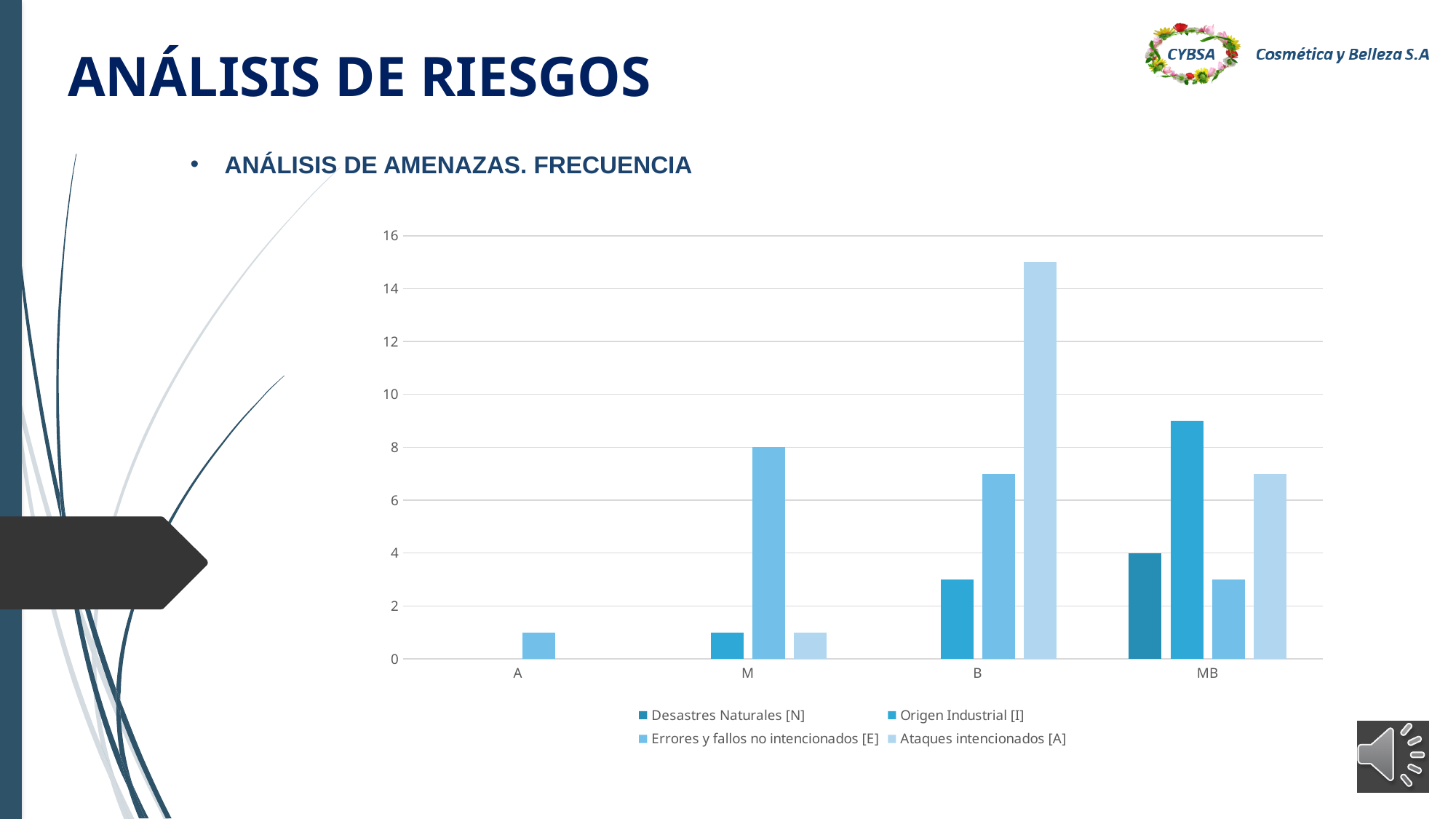
Is the value for Errores y fallos no intencionados [E] in category MB greater or less than 4? less Is the value for Origen Industrial [I] in category MB greater or less than 8? greater Which is larger: Errores y fallos no intencionados [E] in category M or Ataques intencionados [A] in category B? Ataques intencionados [A] in category B What is the value for Errores y fallos no intencionados [E] in category M? 8 Which series has the highest bar in category B? Ataques intencionados [A] Which category has the tallest bar in the chart? B What is the heading given above the chart? ANÁLISIS DE AMENAZAS. FRECUENCIA Is the value for Ataques intencionados [A] in category B greater or less than 14? greater What kind of chart is shown on the slide? bar chart How many categories are shown on the x axis of the chart? 4 How many series does the chart's legend list? 4 What is the value for Desastres Naturales [N] in category MB? 4